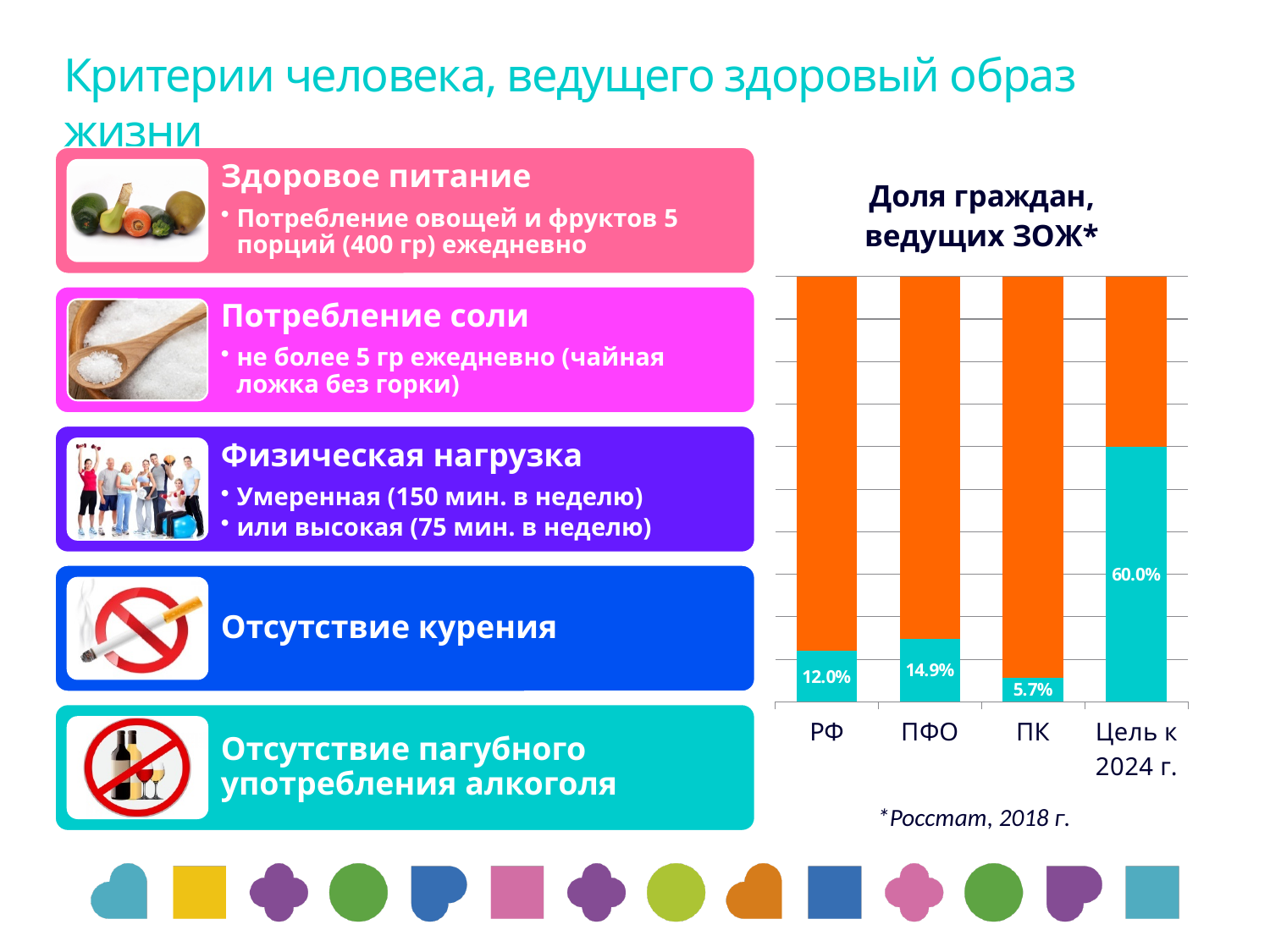
What is the value for РФ in the chart 'Доля граждан, ведущих ЗОЖ*'? 12.0% What is the value for ПФО in the chart 'Доля граждан, ведущих ЗОЖ*'? 14.9% What is the value for ПК in the chart 'Доля граждан, ведущих ЗОЖ*'? 5.7% Which category has the lowest labelled value in the chart 'Доля граждан, ведущих ЗОЖ*'? ПК What source is cited below the chart 'Доля граждан, ведущих ЗОЖ*'? Росстат, 2018 г. Which category has the highest labelled value in the chart 'Доля граждан, ведущих ЗОЖ*'? Цель к 2024 г. What is the value for 'Цель к 2024 г.' in the chart 'Доля граждан, ведущих ЗОЖ*'? 60.0% How many categories are shown on the x axis of the chart 'Доля граждан, ведущих ЗОЖ*'? 4 What is the difference between the value for 'Цель к 2024 г.' and the value for РФ in the chart 'Доля граждан, ведущих ЗОЖ*'? 48.0% What is the difference between the values for ПФО and РФ in the chart 'Доля граждан, ведущих ЗОЖ*'? 2.9% What type of chart is 'Доля граждан, ведущих ЗОЖ*'? Stacked bar chart Which is larger in the chart 'Доля граждан, ведущих ЗОЖ*': the value for РФ or the value for ПК? РФ